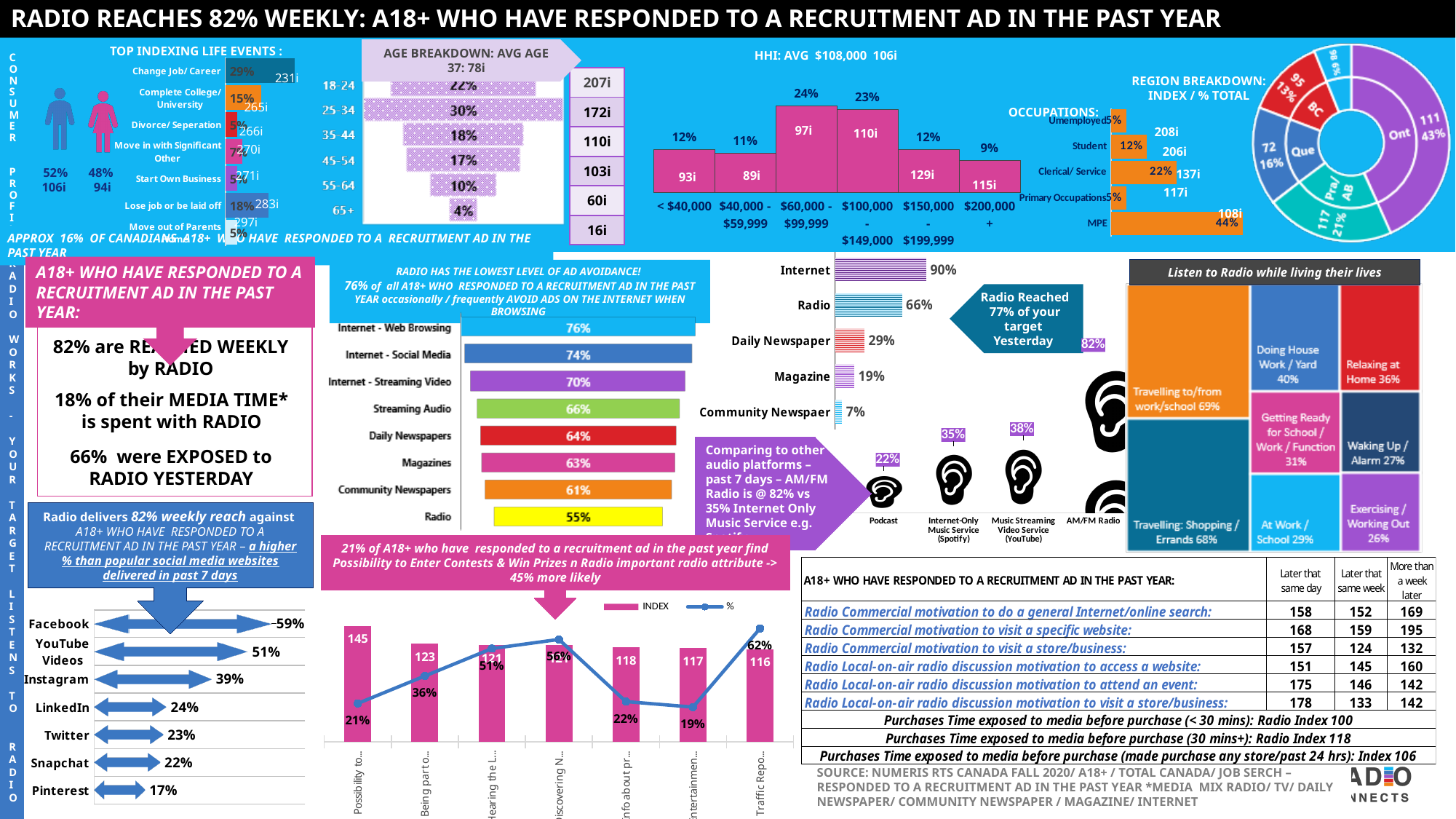
In the social media weekly reach chart (bottom left), which platform has the lowest percentage? Pinterest In the audio platforms comparison (ear icons), which platform has the highest percentage? AM/FM Radio In the media exposed yesterday chart (Internet, Radio, Daily Newspaper, Magazine, Community Newspaper), what percentage is shown for Daily Newspaper? 29% In the ad avoidance bar chart (middle of the slide), what percentage is shown for Radio? 55% In the social media weekly reach chart (bottom left), how many platforms are listed? 7 In the ad avoidance bar chart (middle of the slide), which medium has the highest percentage? Internet - Web Browsing In the social media weekly reach chart (bottom left), what percentage is shown for Instagram? 39% In the audio platforms comparison (ear icons), which is larger: Podcast or Internet-Only Music Service (Spotify)? Internet-Only Music Service (Spotify) In the ad avoidance bar chart (middle of the slide), what is the difference between Internet - Web Browsing and Radio? 21% In the radio attributes chart at the bottom centre, how many series does the legend list? 2 In the HHI bar chart, what percentage is shown for the $60,000 - $99,999 income group? 24% In the HHI bar chart, what index is shown for the $150,000 - $199,999 income group? 129i